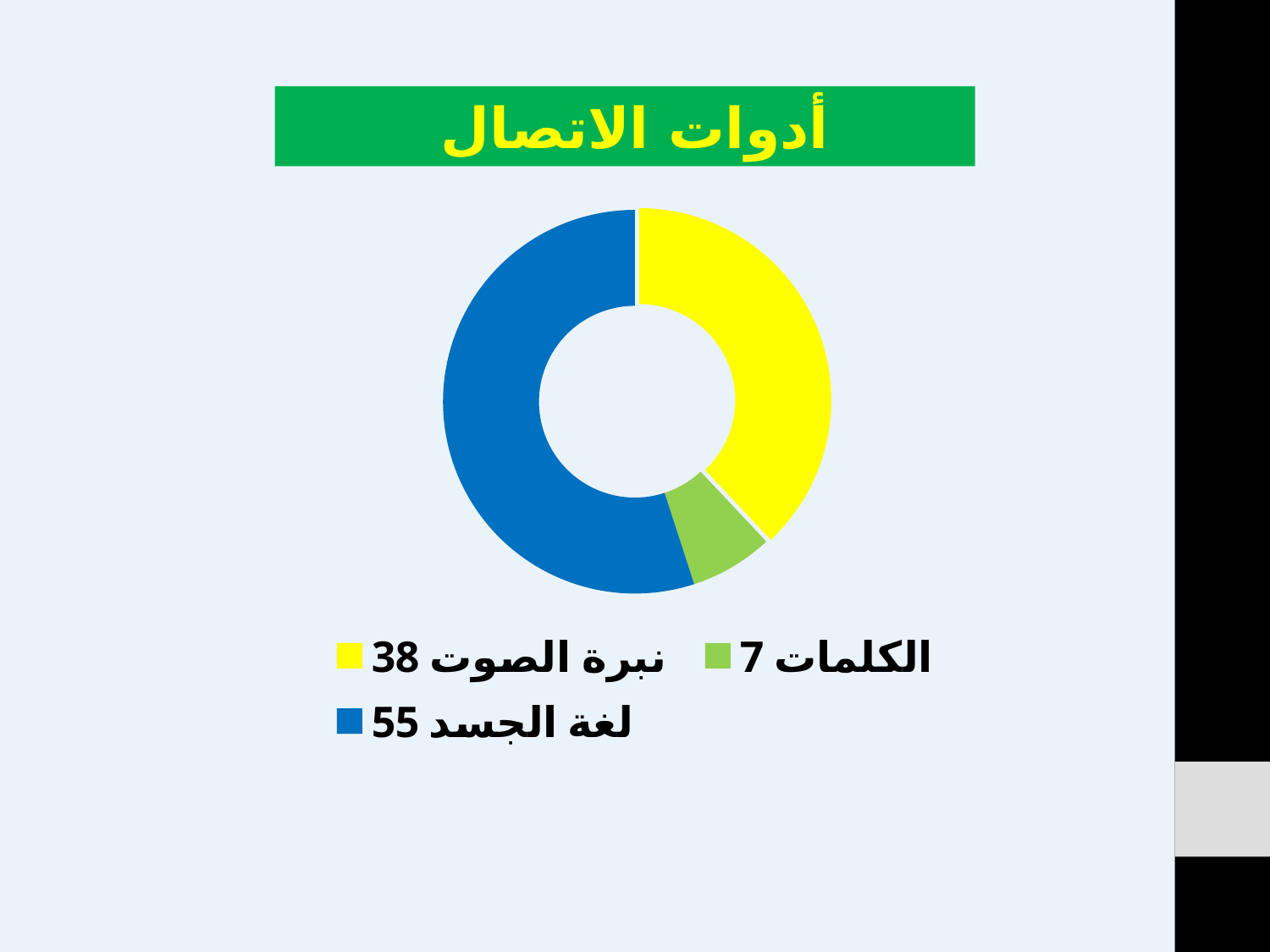
What is the title of the chart? أدوات الاتصال Which is larger, نبرة الصوت or الكلمات? نبرة الصوت Which category has the smallest slice? الكلمات What share of the total do the three values give to لغة الجسد? 55% What value is shown for لغة الجسد in the legend? 55 How many categories does the chart show? 3 Which category has the largest slice? لغة الجسد What colour is the slice for الكلمات? Green What is the difference between the values for لغة الجسد and نبرة الصوت? 17 What kind of chart is shown on the slide? Doughnut (pie) chart What value is shown for نبرة الصوت in the legend? 38 What value is shown for الكلمات in the legend? 7